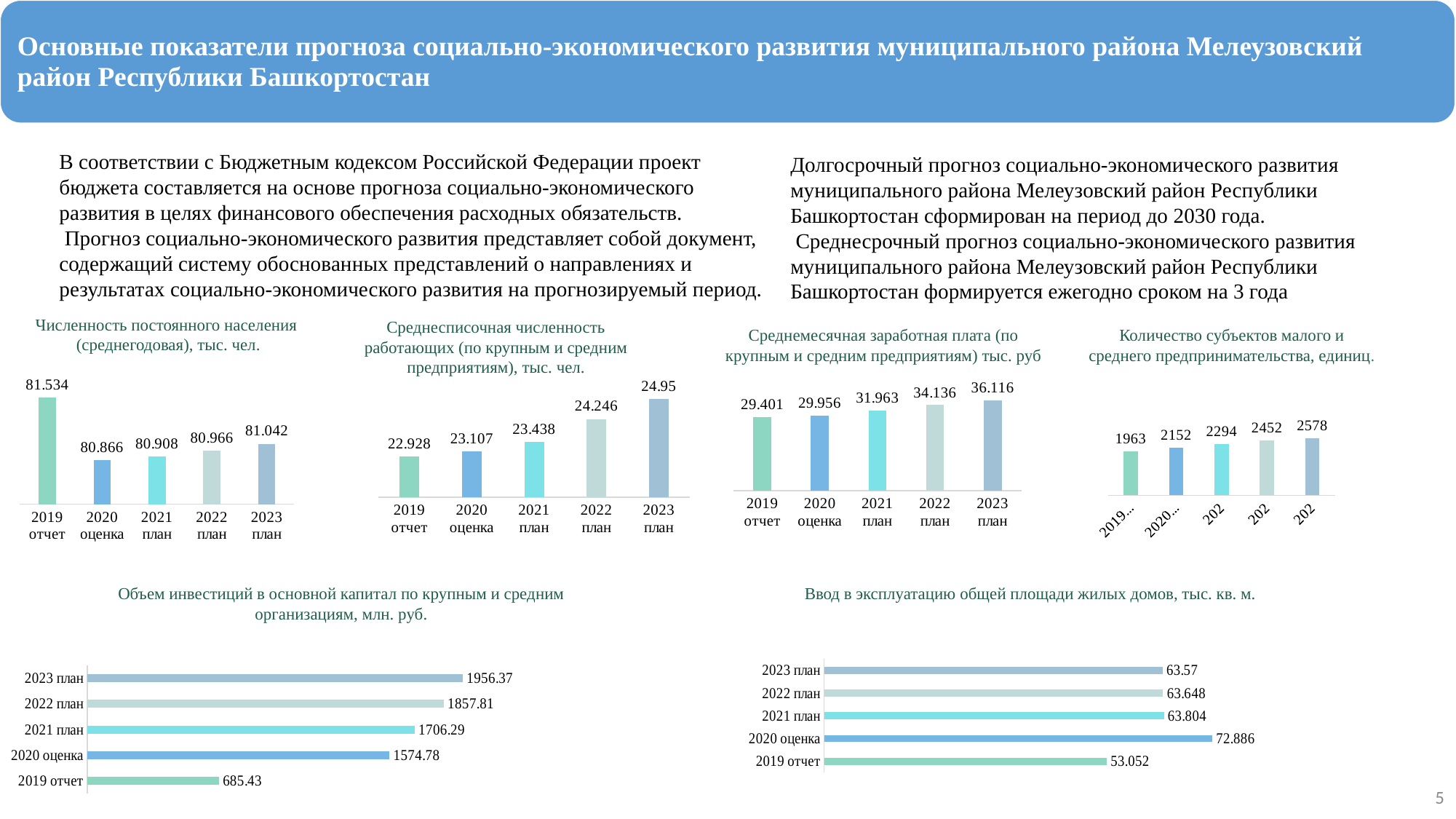
In the chart 'Среднемесячная заработная плата (по крупным и средним предприятиям) тыс. руб', what is the difference between the 2023 план and 2019 отчет values? 6.715 In the chart 'Среднемесячная заработная плата (по крупным и средним предприятиям) тыс. руб', what is the value for 2022 план? 34.136 In the chart 'Численность постоянного населения (среднегодовая), тыс. чел.', which category has the lowest value? 2020 оценка In the chart 'Среднесписочная численность работающих (по крупным и средним предприятиям), тыс. чел.', do the values rise or fall from 2019 to 2023? rise In the chart 'Ввод в эксплуатацию общей площади жилых домов, тыс. кв. м.', which category has the highest value? 2020 оценка In the chart 'Ввод в эксплуатацию общей площади жилых домов, тыс. кв. м.', which is larger: the value for 2021 план or 2019 отчет? 2021 план What type of chart is 'Объем инвестиций в основной капитал по крупным и средним организациям, млн. руб.'? bar chart How many bars are in the chart 'Количество субъектов малого и среднего предпринимательства, единиц.'? 5 In the chart 'Среднесписочная численность работающих (по крупным и средним предприятиям), тыс. чел.', what is the value for 2023 план? 24.95 In the chart 'Численность постоянного населения (среднегодовая), тыс. чел.', what is the value for 2019 отчет? 81.534 In the chart 'Объем инвестиций в основной капитал по крупным и средним организациям, млн. руб.', what is the value for 2019 отчет? 685.43 In the chart 'Количество субъектов малого и среднего предпринимательства, единиц.', what is the highest value shown? 2578